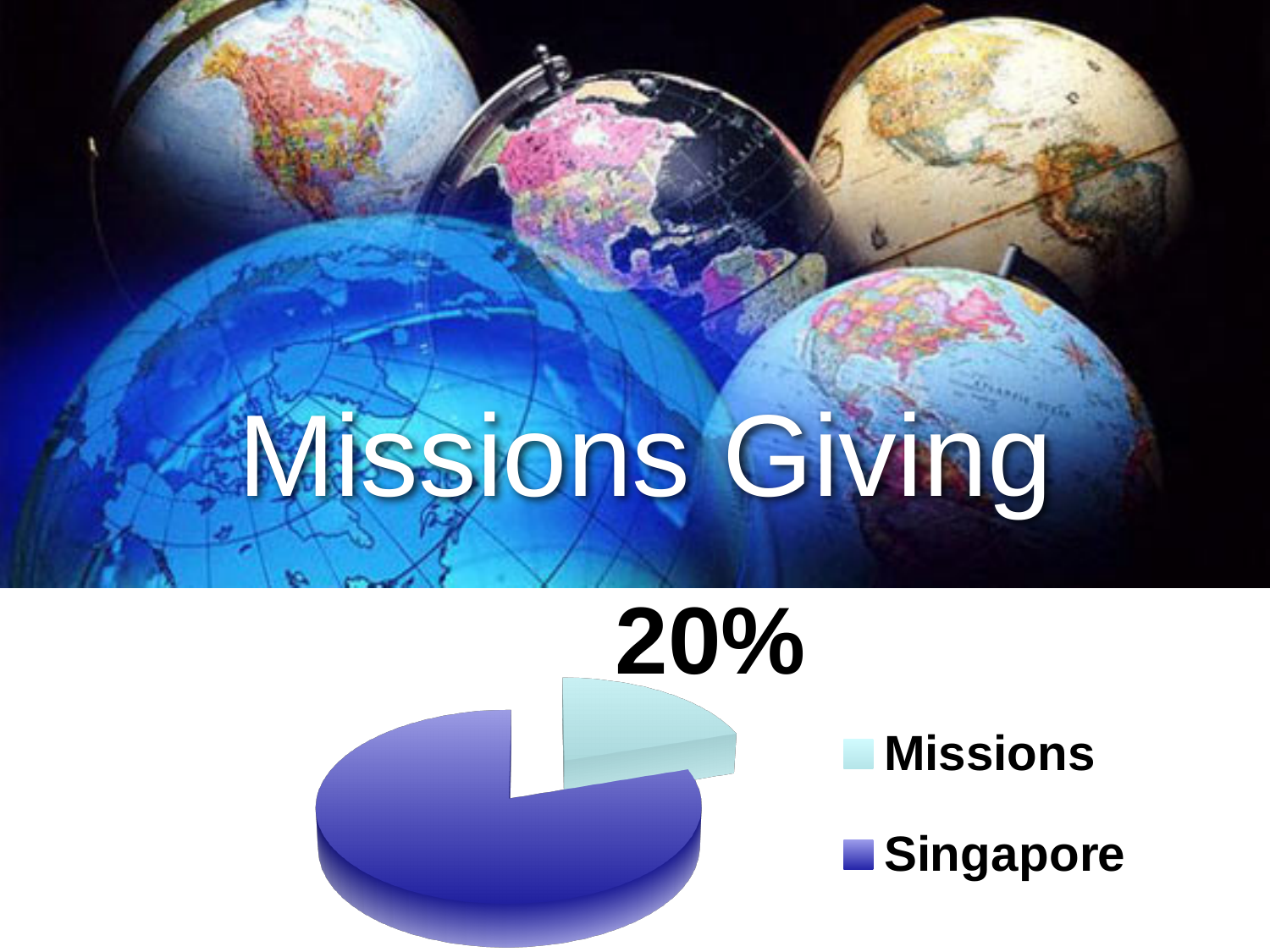
Which slice is larger, Missions or Singapore? Singapore What kind of chart is shown on the slide? pie chart Is the Singapore share of the pie greater or less than 50%? greater Is the Missions share of the pie greater or less than 50%? less How many slices does the pie chart have? 2 Which category has the largest slice of the pie? Singapore Which legend entry is shown in the light blue colour? Missions What is the title shown on the slide above the chart? Missions Giving Which category has the smallest slice of the pie? Missions How many entries does the legend list? 2 What percentage of giving does the Missions slice represent? 20%